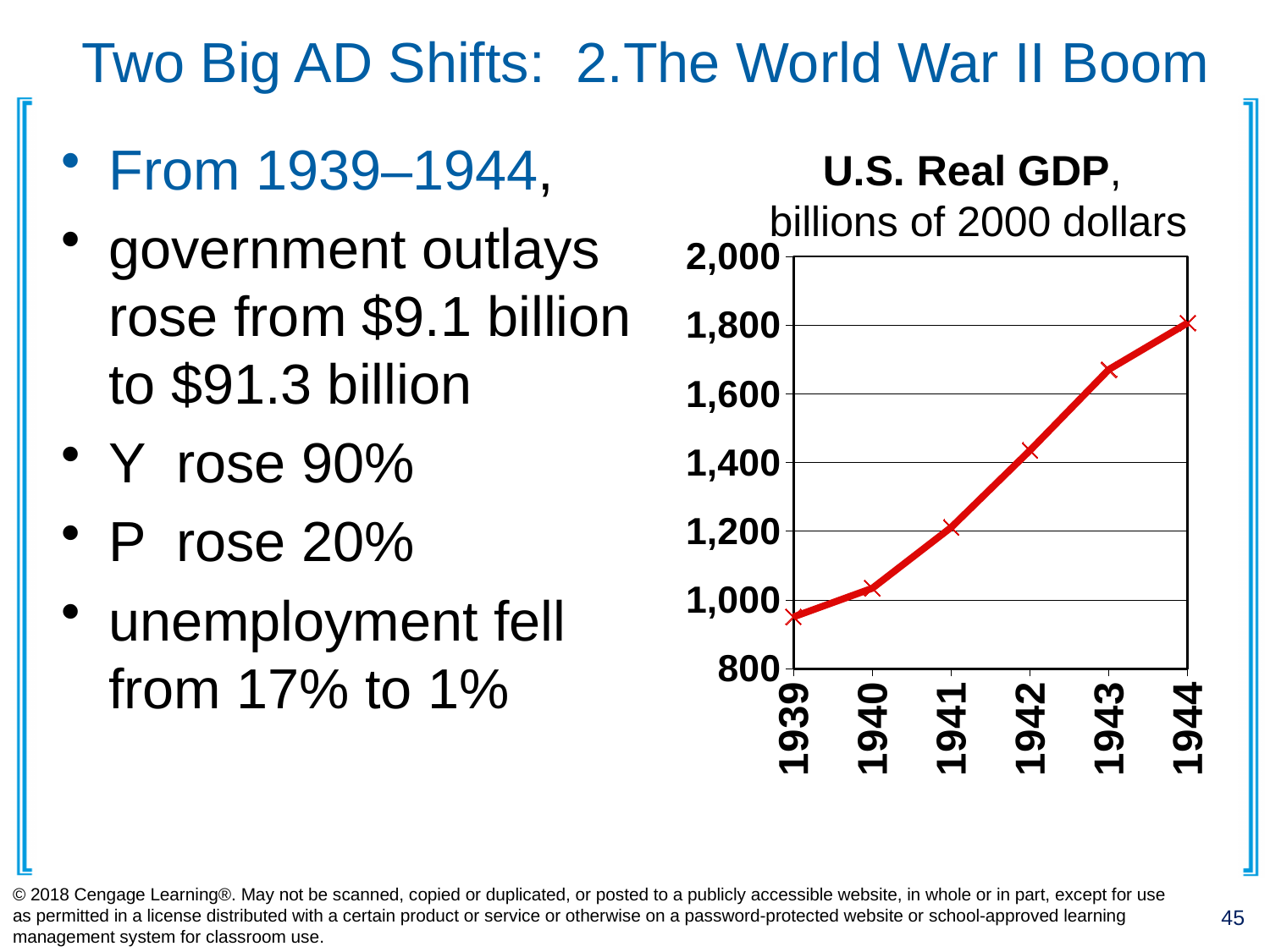
Is the value for 1941 greater or less than 1,400? less Which year has the lowest U.S. Real GDP on the chart? 1939 How many years are plotted on the chart? 6 Is the value for 1943 greater or less than 1,600? greater What is the title of the chart? U.S. Real GDP Does U.S. Real GDP rise or fall from 1939 to 1944? rise Is the value for 1944 greater or less than 2,000? less Which year has the highest U.S. Real GDP on the chart? 1944 In what units is U.S. Real GDP measured on the chart? billions of 2000 dollars Which is larger, the U.S. Real GDP in 1942 or in 1940? 1942 What kind of chart is shown on the slide? line chart